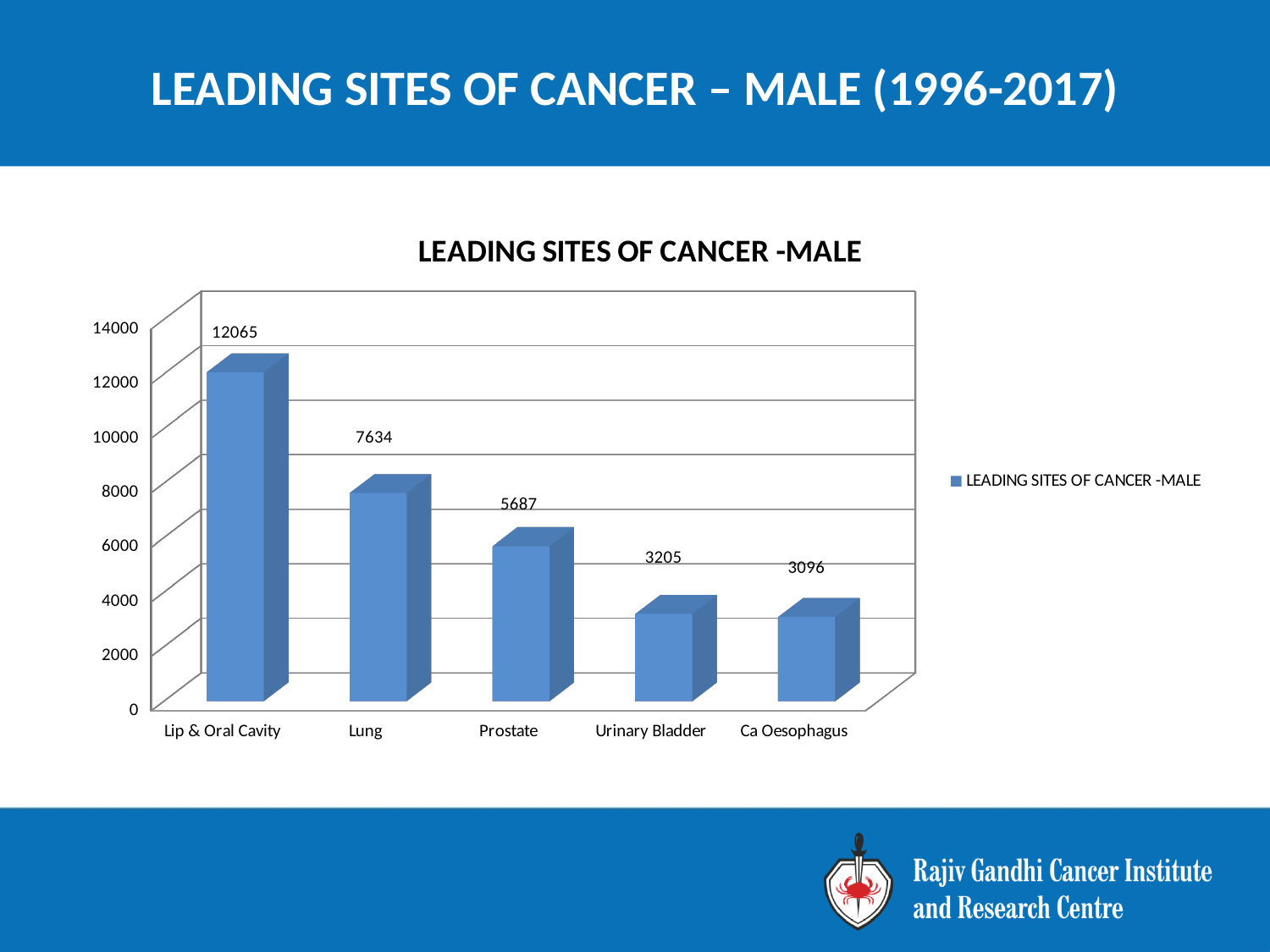
Which is larger, the value for Lung or the value for Prostate? Lung What is the value for Lip & Oral Cavity? 12065 Which cancer site has the highest value? Lip & Oral Cavity Which cancer site has the lowest value? Ca Oesophagus What is the difference between the values for Urinary Bladder and Ca Oesophagus? 109 What kind of chart is shown on the slide? Bar chart What is the difference between the values for Lip & Oral Cavity and Lung? 4431 How many cancer sites are shown on the chart? 5 What is the value for Prostate? 5687 What is the value for Lung? 7634 What is the title of the chart? LEADING SITES OF CANCER -MALE What is the value for Ca Oesophagus? 3096